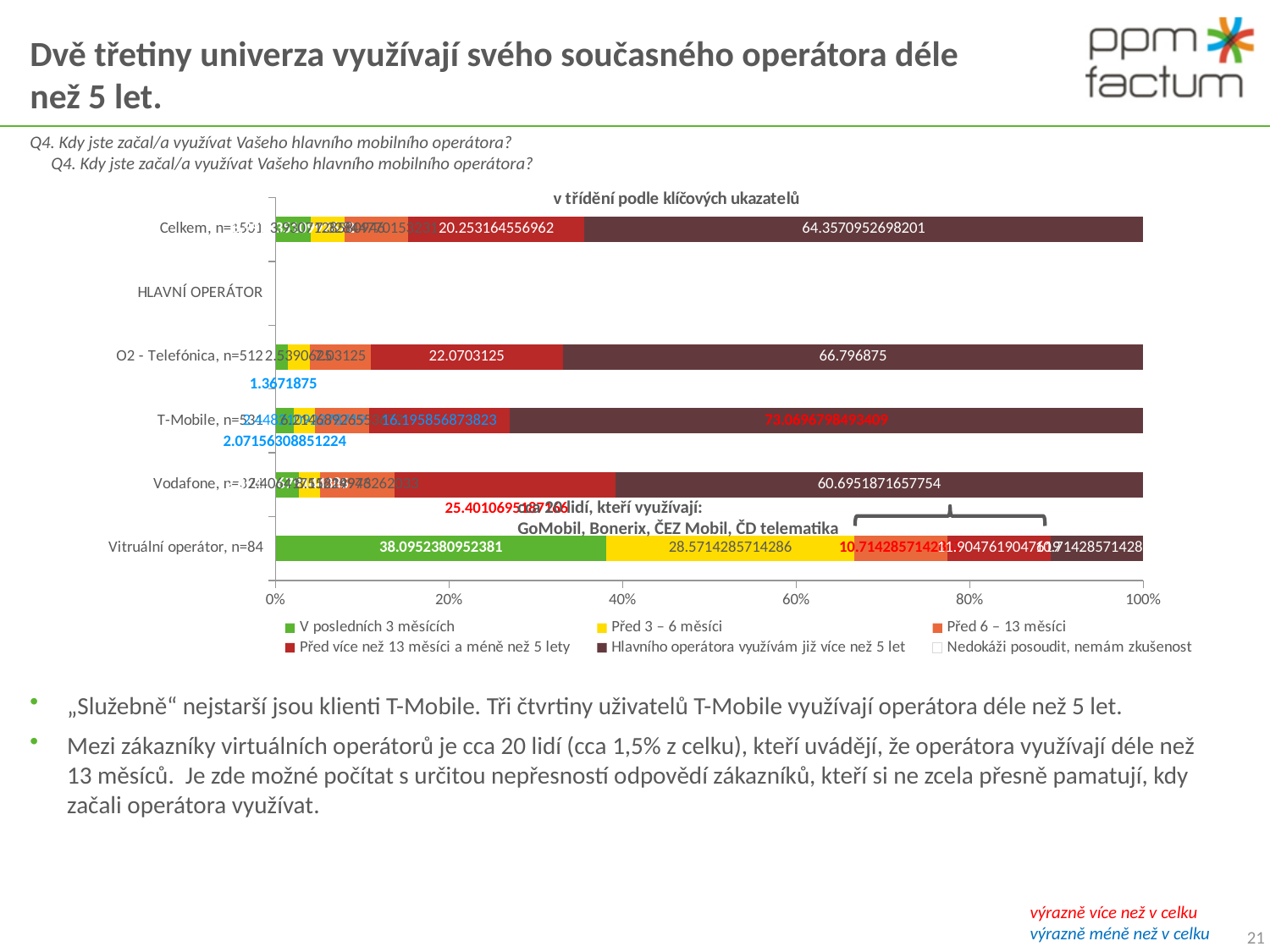
What is the value for 'Hlavního operátora využívám již více než 5 let' in the 'Celkem, n=1501' bar? 64.3570952698201 What is the value for 'Před více než 13 měsíci a méně než 5 lety' in the 'O2 - Telefónica, n=512' bar? 22.0703125 What is the difference between T-Mobile and O2 - Telefónica for 'Hlavního operátora využívám již více než 5 let'? 6.2728048493409 What is the value for 'V posledních 3 měsících' in the 'Vitruální operátor, n=84' bar? 38.0952380952381 What kind of chart is shown on the slide? Stacked bar chart What is the value for 'Před 3 – 6 měsíci' in the 'Vitruální operátor, n=84' bar? 28.5714285714286 Which of O2 - Telefónica and Vodafone has the larger share of 'Hlavního operátora využívám již více než 5 let'? O2 - Telefónica What is the value for 'Hlavního operátora využívám již více než 5 let' in the 'T-Mobile' bar? 73.0696798493409 What is the value for 'Hlavního operátora využívám již více než 5 let' in the 'O2 - Telefónica, n=512' bar? 66.796875 What is the value for 'Hlavního operátora využívám již více než 5 let' in the 'Vodafone' bar? 60.6951871657754 Which operator has the highest share of 'Hlavního operátora využívám již více než 5 let'? T-Mobile How many series does the legend list? 6